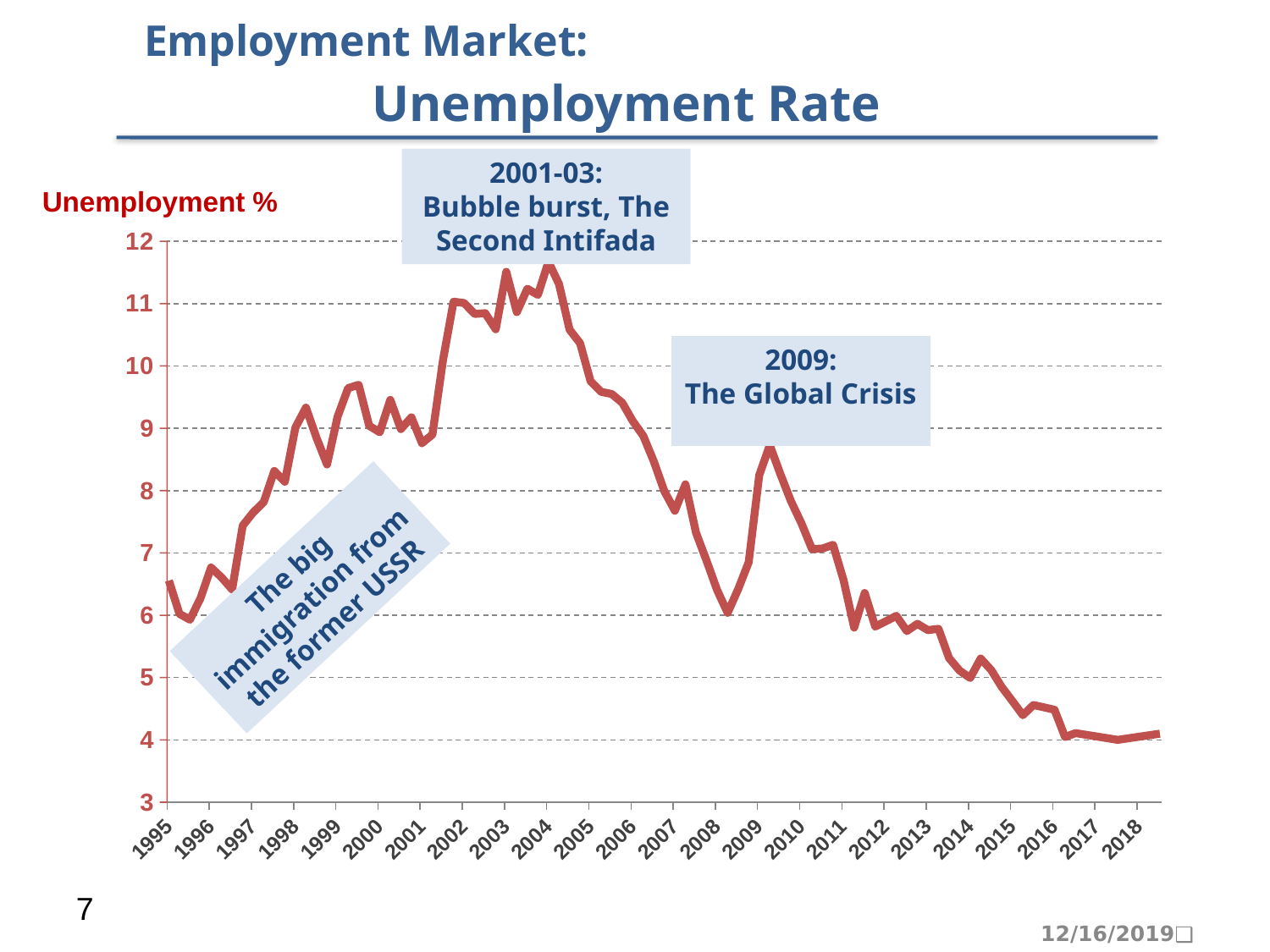
What kind of chart is shown on the slide? line chart Which is higher, the unemployment rate at the start of 2003 or at the start of 2010? 2003 Is the unemployment rate at the start of 2010 greater or less than 7? greater What is the label on the vertical axis of the chart? Unemployment % How many year labels are shown on the x axis? 24 Which is higher, the unemployment rate at the start of 1995 or at the start of 2018? 1995 Is the unemployment rate at the start of 2003 greater or less than 10? greater Is the unemployment rate at the start of 1995 greater or less than 6? greater What event does the annotation for 2009 name? The Global Crisis Does the unemployment rate generally rise or fall between 2009 and 2018? fall